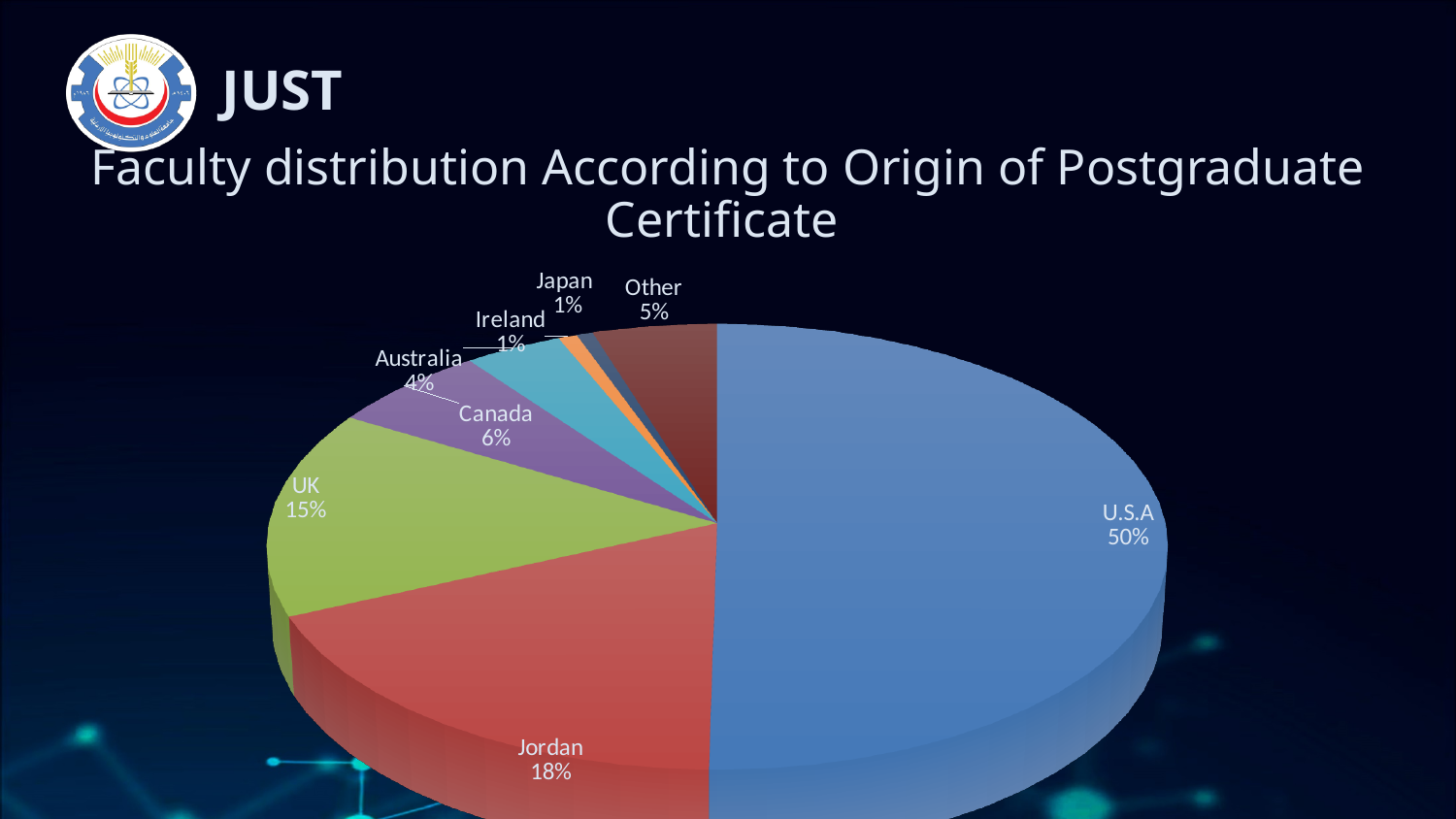
What is the combined share of Ireland and Japan? 2% What percentage is shown for Australia? 4% What share of the pie does U.S.A account for? 50% What percentage is shown for the UK? 15% What is the title of the chart? Faculty distribution According to Origin of Postgraduate Certificate What percentage is shown for Jordan? 18% How many slices does the pie chart have? 8 What percentage is shown for Canada? 6% What type of chart is shown on the slide? Pie chart Which is larger, the share for Canada or the share for Other? Canada What is the difference in percentage points between Jordan and the UK? 3 Which category has the largest share of the pie? U.S.A